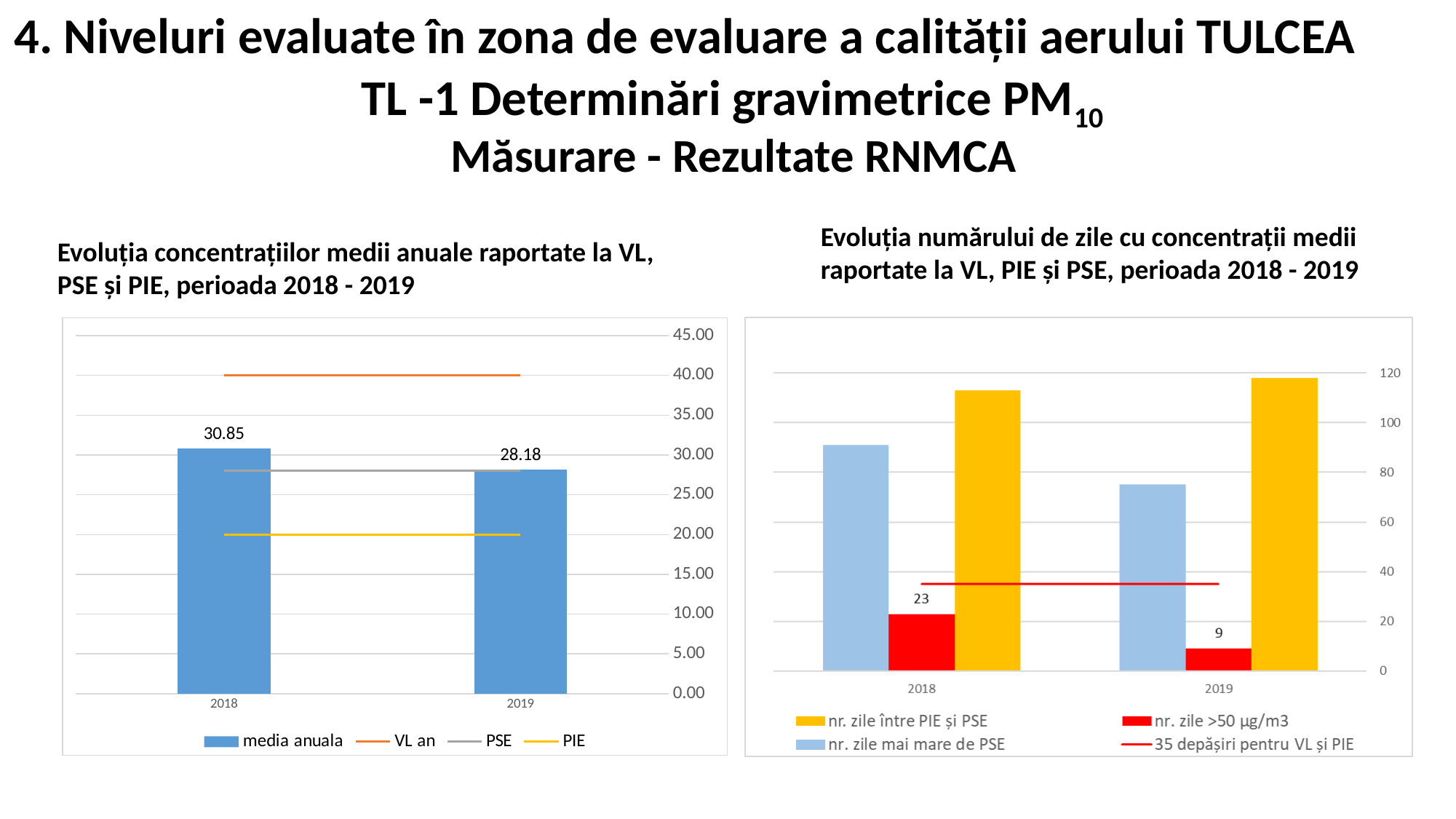
In the left chart (Evoluția concentrațiilor medii anuale), is the VL an line greater or less than 35.00? greater In the right chart (Evoluția numărului de zile), what is the value of nr. zile >50 µg/m3 for 2018? 23 In the left chart (Evoluția concentrațiilor medii anuale), what is the value of media anuala for 2019? 28.18 In the right chart (Evoluția numărului de zile), which series is shown in yellow? nr. zile între PIE și PSE In the left chart (Evoluția concentrațiilor medii anuale), which year has the higher media anuala, 2018 or 2019? 2018 In the left chart (Evoluția concentrațiilor medii anuale), what is the difference between the media anuala values for 2018 and 2019? 2.67 In the right chart (Evoluția numărului de zile), is the value of nr. zile mai mare de PSE for 2018 greater or less than 80? greater In the right chart (Evoluția numărului de zile), what is the value of nr. zile >50 µg/m3 for 2019? 9 In the left chart (Evoluția concentrațiilor medii anuale), how many series does the legend list? 4 In the right chart (Evoluția numărului de zile), what is the difference between the nr. zile >50 µg/m3 values for 2018 and 2019? 14 In the left chart (Evoluția concentrațiilor medii anuale), what is the value of media anuala for 2018? 30.85 In the left chart (Evoluția concentrațiilor medii anuale), does the media anuala rise or fall from 2018 to 2019? fall